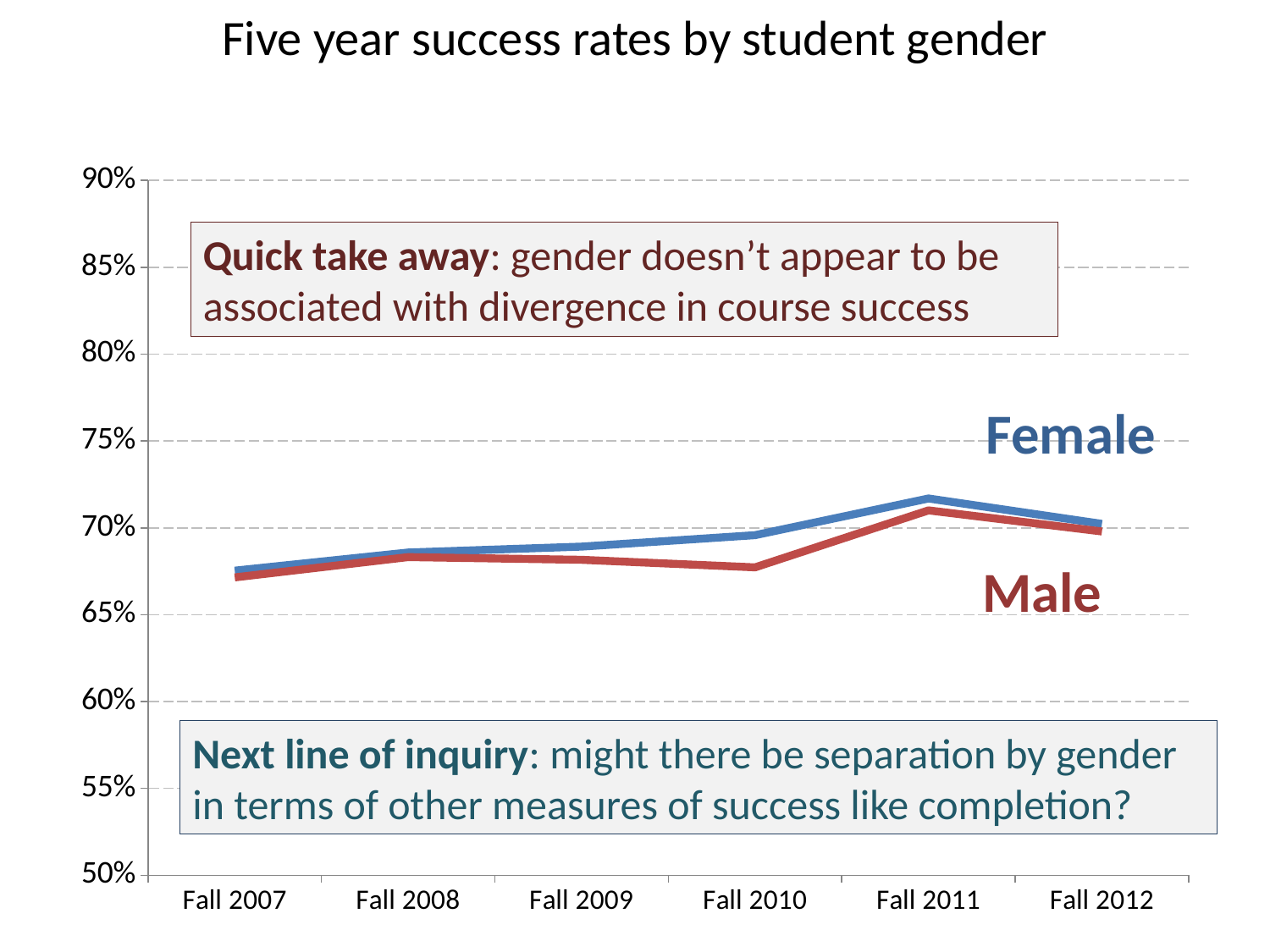
Which series is drawn in blue? Female Is the Male value for Fall 2010 greater or less than 70%? less What is the title of the chart? Five year success rates by student gender Does the Female series rise or fall from Fall 2007 to Fall 2011? rise How many series are plotted on the chart? 2 In which term does the Female series reach its highest value? Fall 2011 Is the Female value for Fall 2007 greater or less than 65%? greater What kind of chart is shown on the slide? line chart Is the Male value for Fall 2008 greater or less than 70%? less How many time points are shown along the x axis? 6 In Fall 2011, which series has the higher value, Female or Male? Female